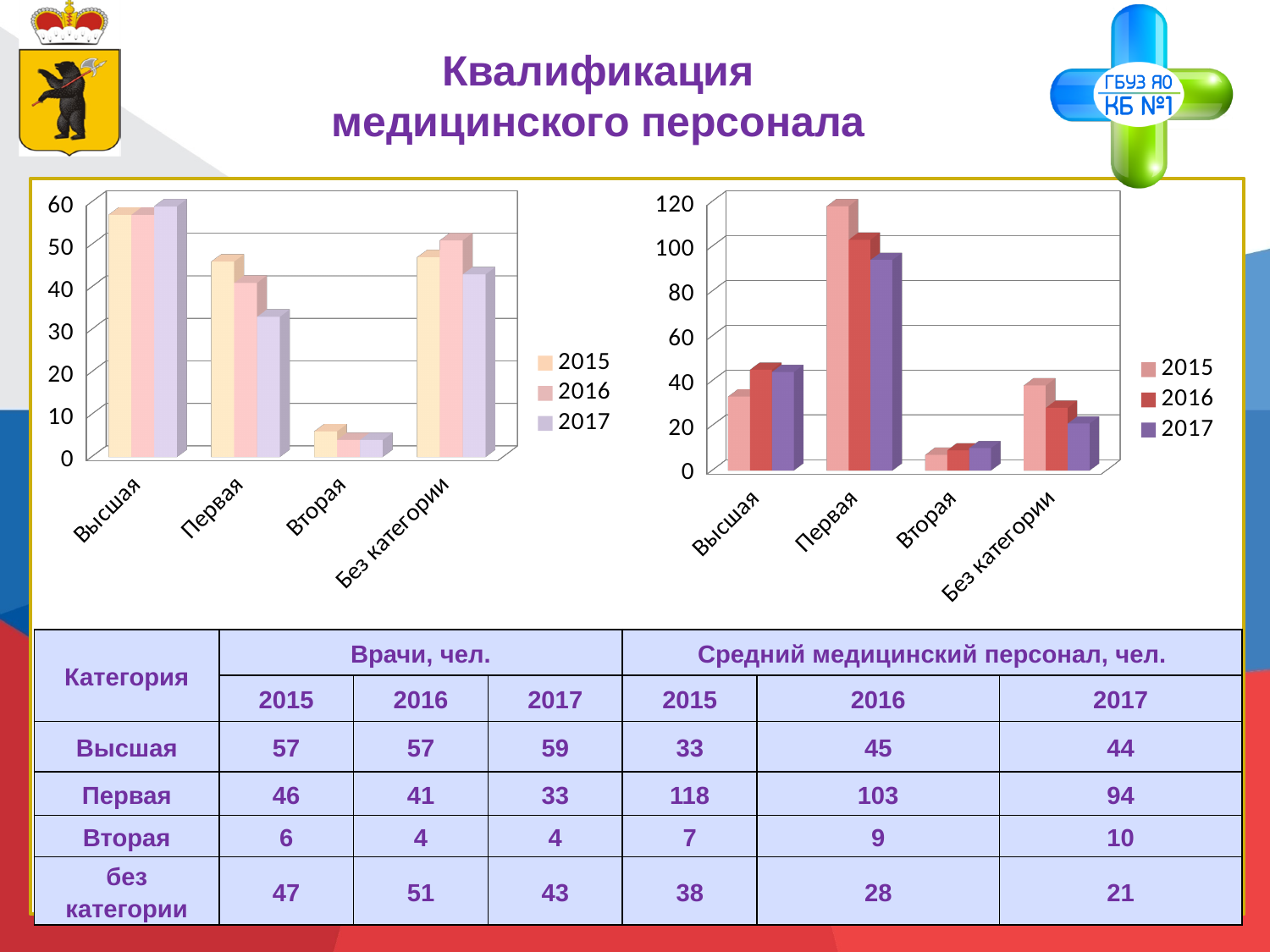
In the right chart, which is larger for Высшая: the 2015 value or the 2016 value? 2016 In the left chart, which category has the lowest values across all years? Вторая How many categories are shown on the x axis of the left chart? 4 In the right chart, which category has the highest values across all years? Первая In the right chart, is the 2017 value for Первая greater or less than 80? greater What is the title of the slide containing the two charts? Квалификация медицинского персонала In the left chart, is the 2015 value for Первая greater or less than 40? greater In the right chart, do the values for Первая rise or fall from 2015 to 2017? fall In the right chart, do the values for Вторая rise or fall from 2015 to 2017? rise How many series does the legend of the right chart list? 3 In the left chart, which is larger for Без категории: the 2016 value or the 2017 value? 2016 What kind of chart is the left chart on the slide? bar chart